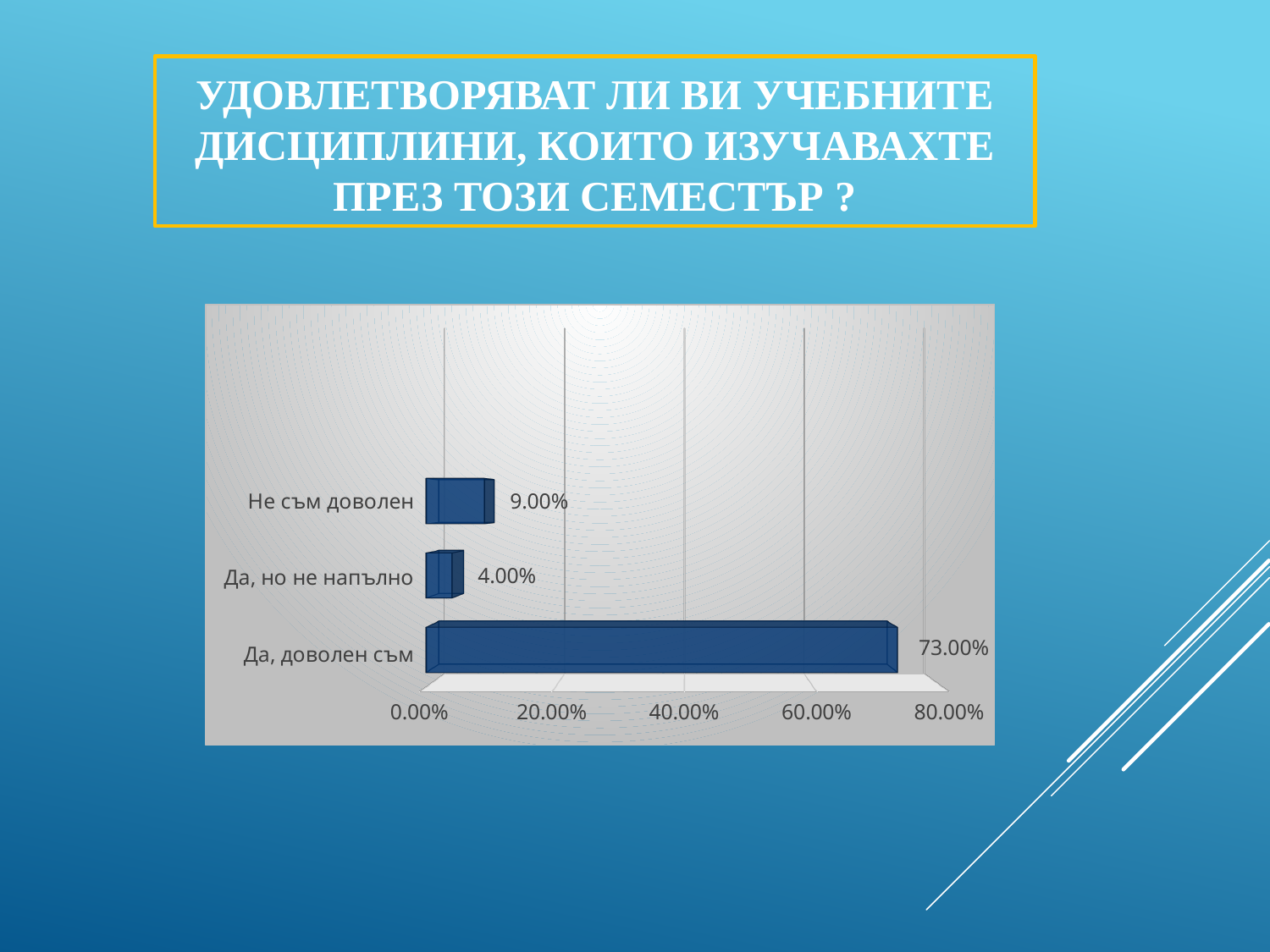
Which category has the highest value? Да, доволен съм How many categories are shown in the chart? 3 What is the highest value shown on the horizontal axis? 80.00% Which category has the lowest value? Да, но не напълно What is the value for "Да, доволен съм"? 73.00% What is the difference between the values for "Да, доволен съм" and "Не съм доволен"? 64.00% Is the value for "Да, доволен съм" greater or less than 60.00%? greater What kind of chart is shown on the slide? bar chart What is the value for "Да, но не напълно"? 4.00% What is the difference between the values for "Не съм доволен" and "Да, но не напълно"? 5.00% Which is larger, the value for "Не съм доволен" or the value for "Да, но не напълно"? Не съм доволен What is the value for "Не съм доволен"? 9.00%